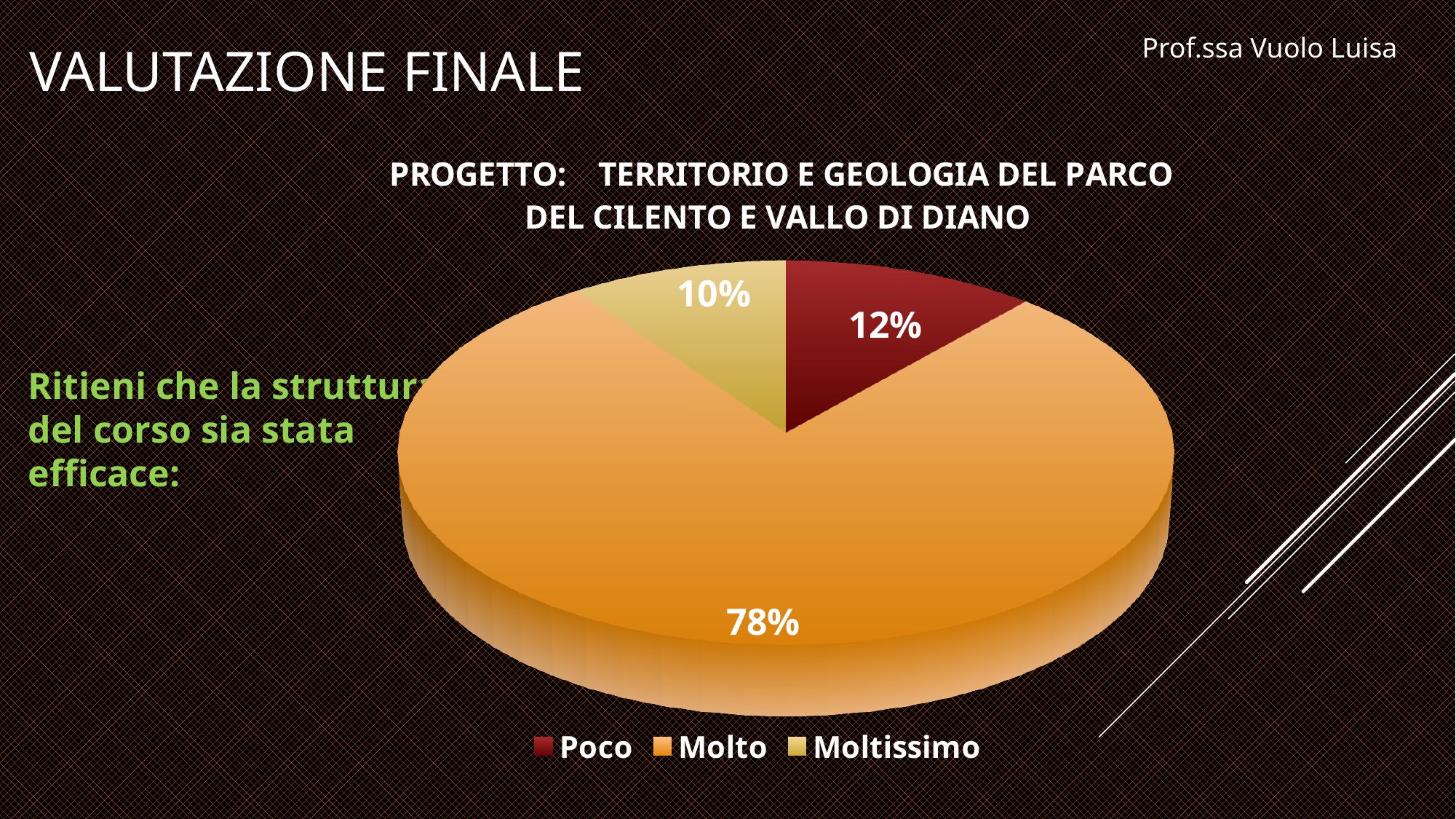
What kind of chart is shown on the slide? Pie chart What percentage of the pie does the Molto slice represent? 78% What is the difference in percentage points between the Molto and Poco slices? 66 What colour is the Poco slice in the pie chart? Dark red What is the difference in percentage points between the Poco and Moltissimo slices? 2 What percentage of the pie does the Poco slice represent? 12% Which slice is larger, Poco or Moltissimo? Poco Which category has the smallest share of the pie? Moltissimo How many entries does the legend list? 3 What percentage of the pie does the Moltissimo slice represent? 10% How many slices does the pie chart have? 3 Which category has the largest share of the pie? Molto